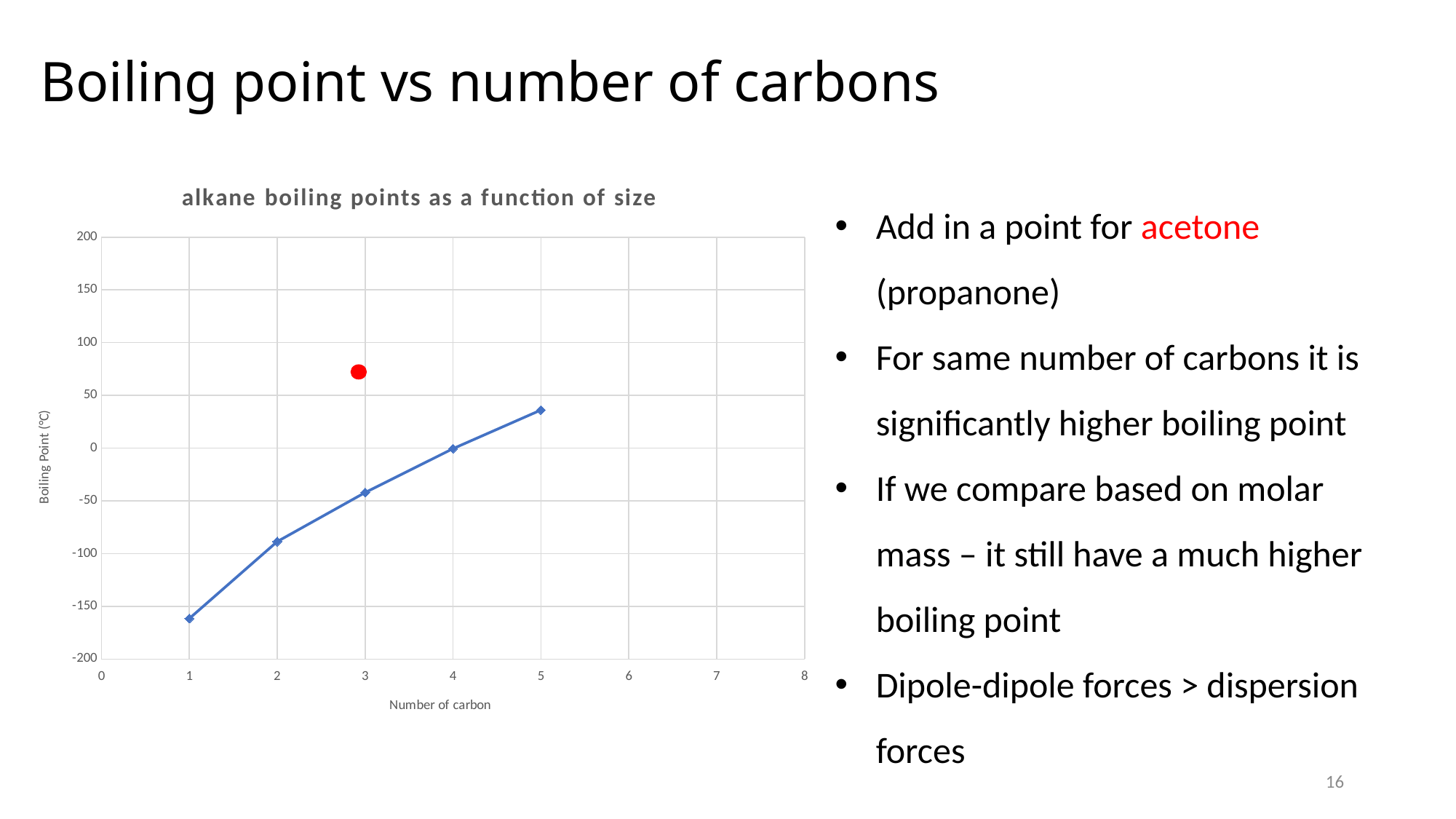
Is the boiling point for 5 carbons greater or less than 50? less Which has the higher boiling point on the blue line, 2 carbons or 4 carbons? 4 carbons Is the boiling point for 2 carbons greater or less than -100? greater Is the boiling point for 1 carbon greater or less than -150? less Which number of carbons has the lowest boiling point on the blue line? 1 What kind of chart is shown on the slide? line chart What is the title of the chart? alkane boiling points as a function of size What is the label of the x axis of the chart? Number of carbon How many data points are plotted on the blue line? 5 Which number of carbons has the highest boiling point on the blue line? 5 Does the boiling point rise or fall as the number of carbons increases along the x axis? rise